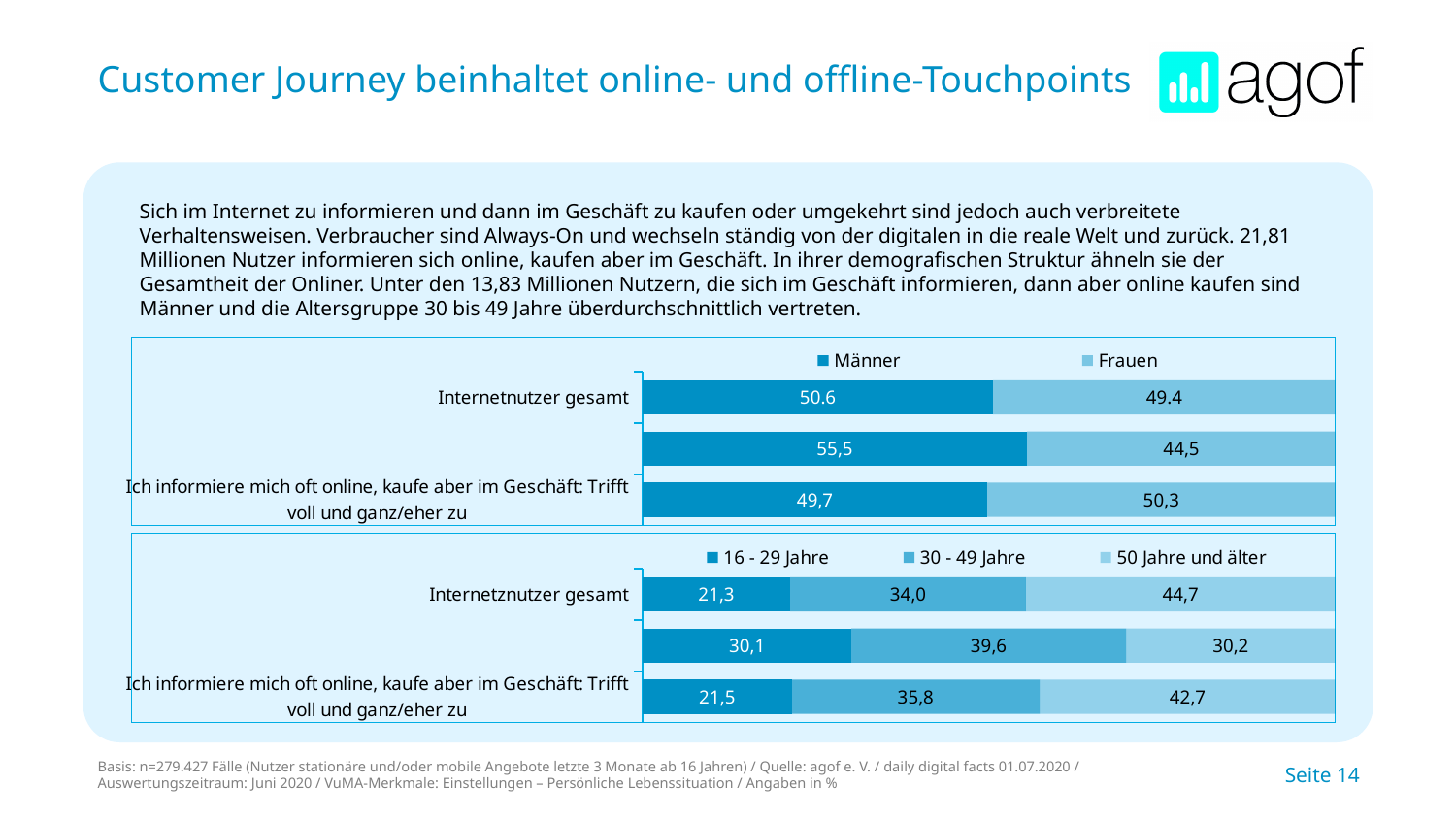
In the top chart (Männer/Frauen), what is the value for Männer in the 'Internetnutzer gesamt' bar? 50.6 In the top chart, for 'Internetnutzer gesamt', which is larger: Männer or Frauen? Männer In the bottom chart, for 'Internetnutzer gesamt', which age group has the highest value? 50 Jahre und älter How many series does the legend of the bottom chart (age groups) list? 3 What kind of chart is the top chart on the slide? Stacked bar chart In the top chart (Männer/Frauen), what is the value for Frauen in the bar 'Ich informiere mich oft online, kaufe aber im Geschäft: Trifft voll und ganz/eher zu'? 50,3 In the bottom chart (age groups), what is the value for '16 - 29 Jahre' in the bar 'Ich informiere mich oft online, kaufe aber im Geschäft: Trifft voll und ganz/eher zu'? 21,5 In the bottom chart (age groups), what is the value for '50 Jahre und älter' in the bar 'Ich informiere mich oft online, kaufe aber im Geschäft: Trifft voll und ganz/eher zu'? 42,7 In the bottom chart (age groups), what is the value for '30 - 49 Jahre' in the 'Internetnutzer gesamt' bar? 34,0 In the top chart (Männer/Frauen), what is the value for Männer in the bar 'Ich informiere mich oft online, kaufe aber im Geschäft: Trifft voll und ganz/eher zu'? 49,7 How many series does the legend of the top chart list? 2 In the bottom chart, for 'Internetnutzer gesamt', what is the difference between '50 Jahre und älter' and '16 - 29 Jahre'? 23,4